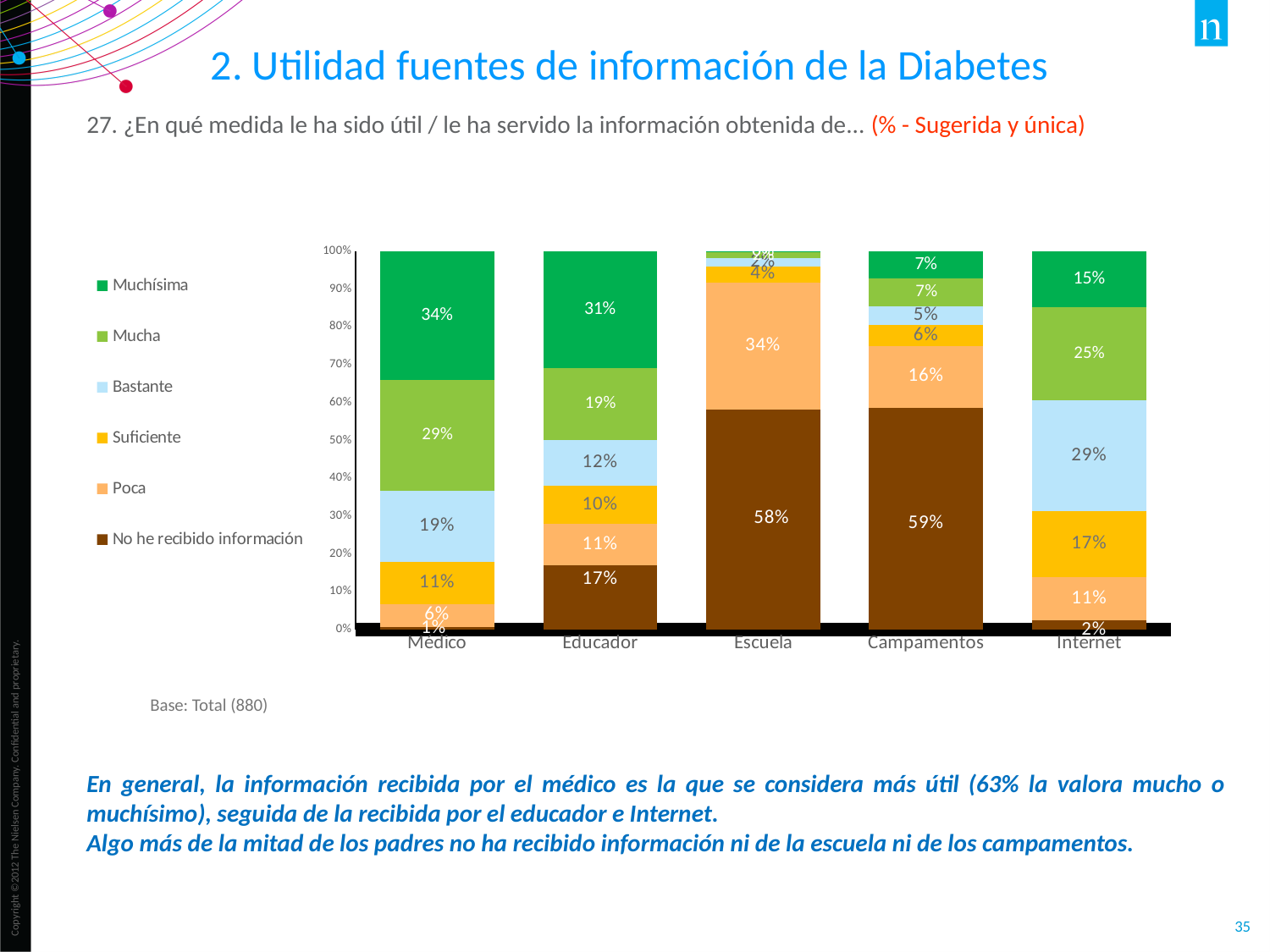
Which is larger, the 'Suficiente' value for Internet or for Educador? Internet What is the 'Bastante' value for Internet? 29% What is the difference between the 'Mucha' values for Médico and Educador? 10% How many categories (information sources) are shown on the x axis of the chart? 5 Which category has the lowest 'No he recibido información' value? Médico What kind of chart is shown on the slide? Stacked bar chart How many series does the legend of the chart list? 6 What is the 'Muchísima' value for Médico? 34% What is the 'No he recibido información' value for Campamentos? 59% Which category has the highest 'Muchísima' value? Médico What is the base (sample size) stated below the chart? Total (880) What is the 'Poca' value for Escuela? 34%